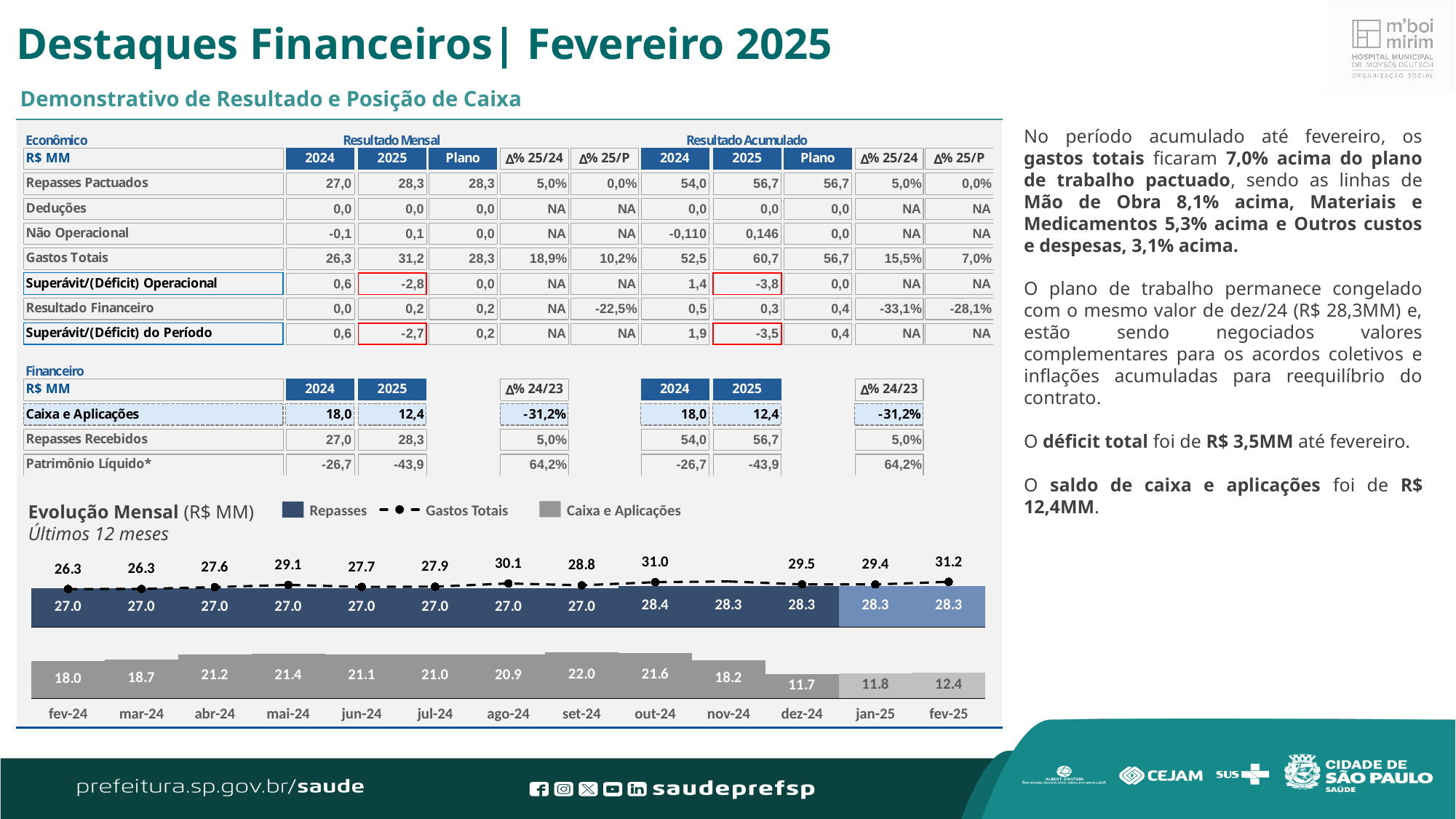
In the Evolução Mensal chart, which month has the highest Caixa e Aplicações value? set-24 How many series does the legend of the Evolução Mensal chart list? 3 In the Evolução Mensal chart, what is the Caixa e Aplicações value for dez-24? 11.7 In the Evolução Mensal chart, which series is drawn as a dashed line? Gastos Totais In the Evolução Mensal chart, what is the Gastos Totais value for fev-25? 31.2 In the Evolução Mensal chart, which is larger for mai-24: Gastos Totais or Repasses? Gastos Totais What kind of chart is the Evolução Mensal chart? Combined bar and line chart In the Evolução Mensal chart, what is the difference between the Caixa e Aplicações values for fev-24 and fev-25? 5.6 How many months are shown on the x axis of the Evolução Mensal chart? 13 In the Evolução Mensal chart, which month has the lowest Caixa e Aplicações value? dez-24 In the Evolução Mensal chart, does the Caixa e Aplicações value rise or fall from set-24 to dez-24? Fall In the Evolução Mensal chart, what is the Repasses value for out-24? 28.4